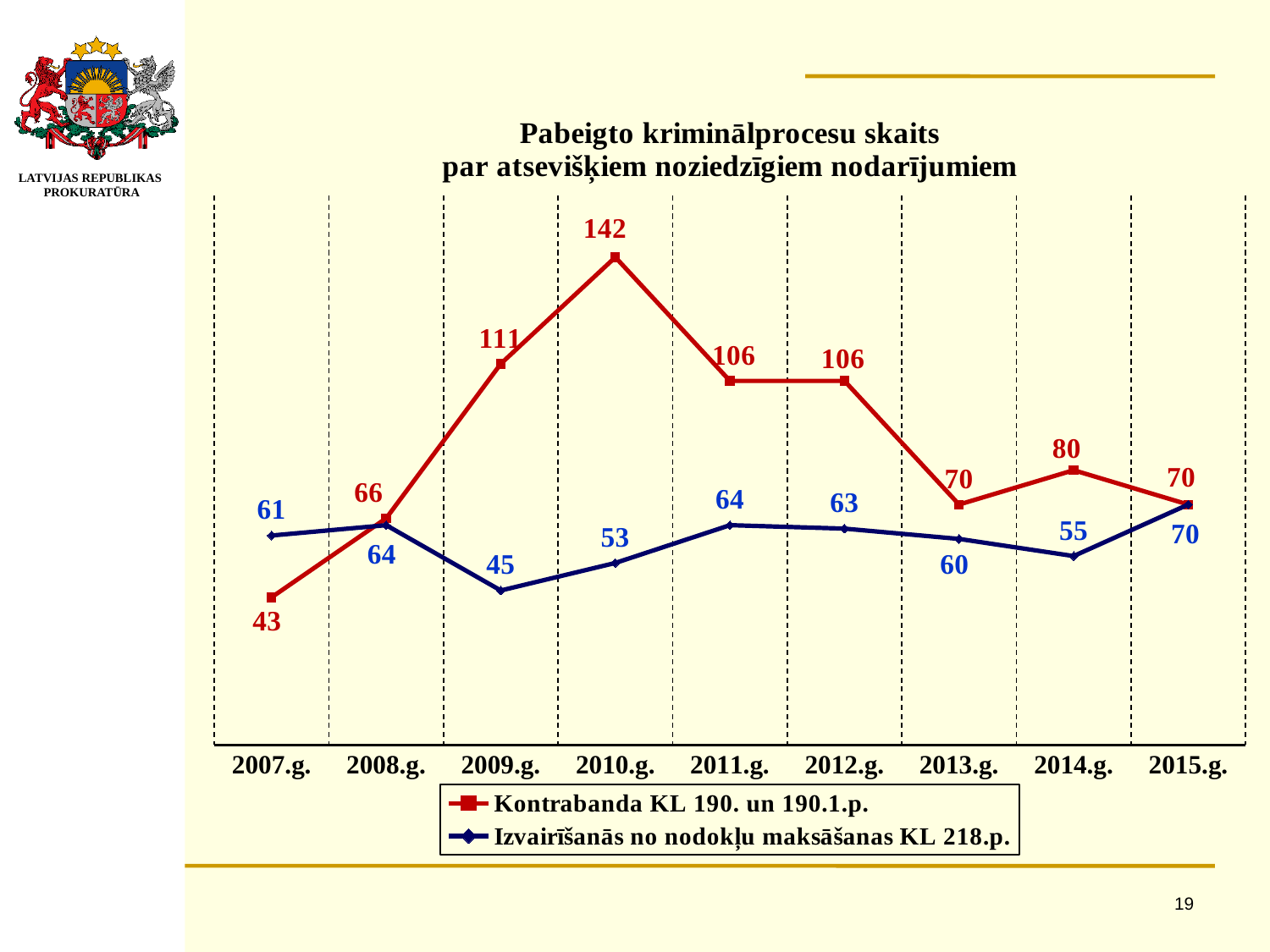
What is the value for Kontrabanda KL 190. un 190.1.p. in 2007.g.? 43 What is the value for Izvairīšanās no nodokļu maksāšanas KL 218.p. in 2009.g.? 45 What is the difference between the Kontrabanda value and the Izvairīšanās no nodokļu maksāšanas value in 2010.g.? 89 What is the title of the chart? Pabeigto kriminālprocesu skaits par atsevišķiem noziedzīgiem nodarījumiem Does the Kontrabanda KL 190. un 190.1.p. series rise or fall from 2010.g. to 2013.g.? Fall How many years are shown on the x axis? 9 What kind of chart is shown on the slide? Line chart How many series does the legend list? 2 What is the value for Kontrabanda KL 190. un 190.1.p. in 2010.g.? 142 In which year is the Izvairīšanās no nodokļu maksāšanas KL 218.p. series at its lowest? 2009.g. Which series has the larger value in 2007.g., Kontrabanda KL 190. un 190.1.p. or Izvairīšanās no nodokļu maksāšanas KL 218.p.? Izvairīšanās no nodokļu maksāšanas KL 218.p. In which year does the Kontrabanda KL 190. un 190.1.p. series reach its highest value? 2010.g.